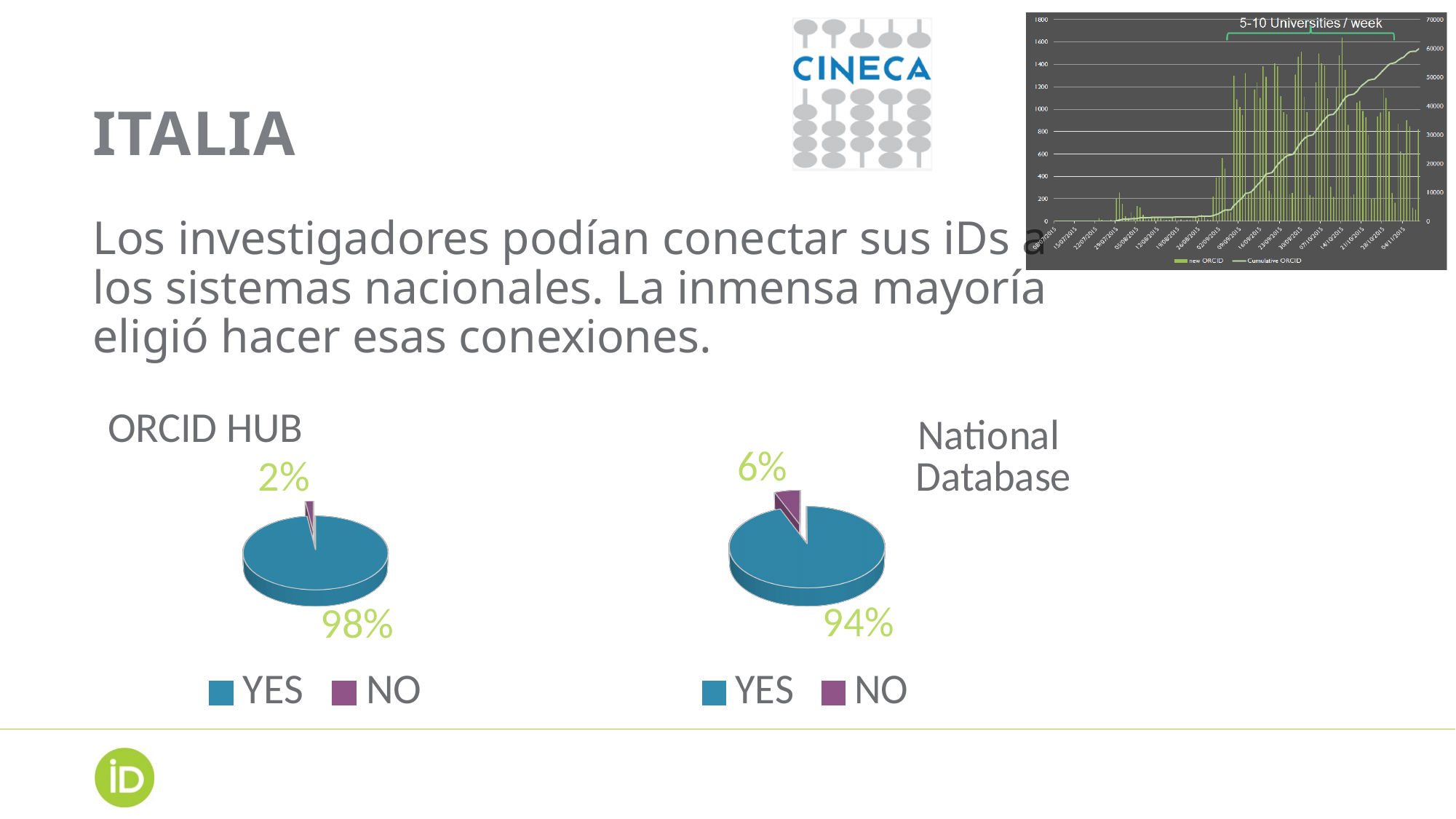
In the ORCID HUB pie chart, what percentage is shown for YES? 98% Is the NO share larger in the ORCID HUB pie chart or in the National Database pie chart? National Database In the National Database pie chart, which category has the smallest slice? NO In the ORCID HUB pie chart, which category has the largest slice? YES What type of chart is the ORCID HUB chart? Pie chart In the National Database pie chart, what colour is the YES slice? Blue In the ORCID HUB pie chart, what percentage is shown for NO? 2% How many categories does the National Database pie chart show? 2 In the National Database pie chart, what percentage is shown for YES? 94% How many entries does the legend of the ORCID HUB pie chart list? 2 In the National Database pie chart, what is the difference between the YES and NO percentages? 88% In the National Database pie chart, what percentage is shown for NO? 6%